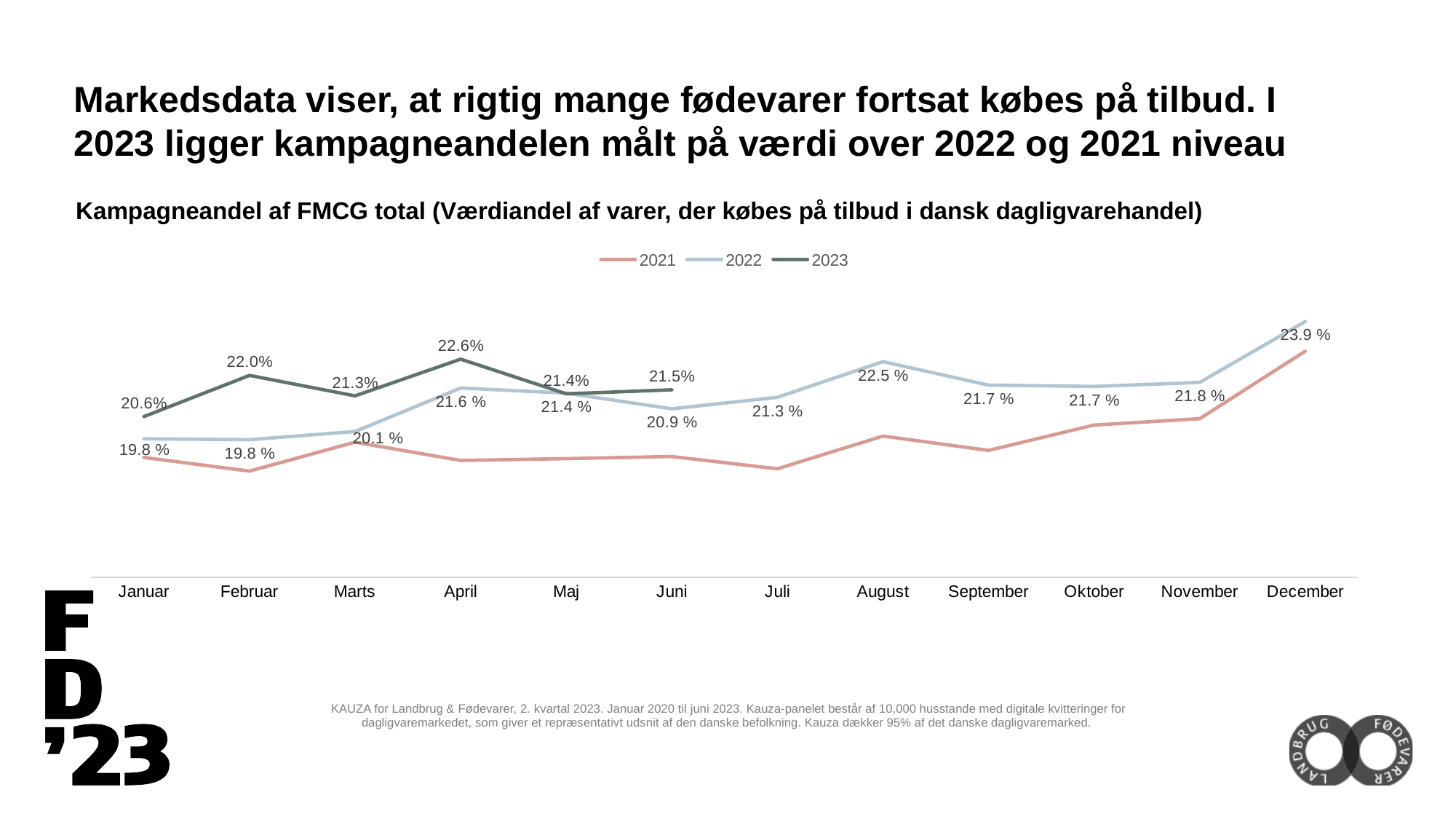
What is the value for April in the 2023 series? 22.6% What kind of chart is shown on the slide? Line chart Does the 2022 series rise or fall from September to December? Rise How many months are shown on the x axis? 12 What is the difference between the 2023 values for April and Januar? 2.0 percentage points What is the value for Februar in the 2023 series? 22.0% Which month has the highest value in the 2023 series? April What is the value for August in the 2022 series? 22.5 % How many series does the legend list? 3 What is the value for December in the 2022 series? 23.9 % Which series has the larger value in April, 2022 or 2023? 2023 Which month has the highest value in the 2022 series? December